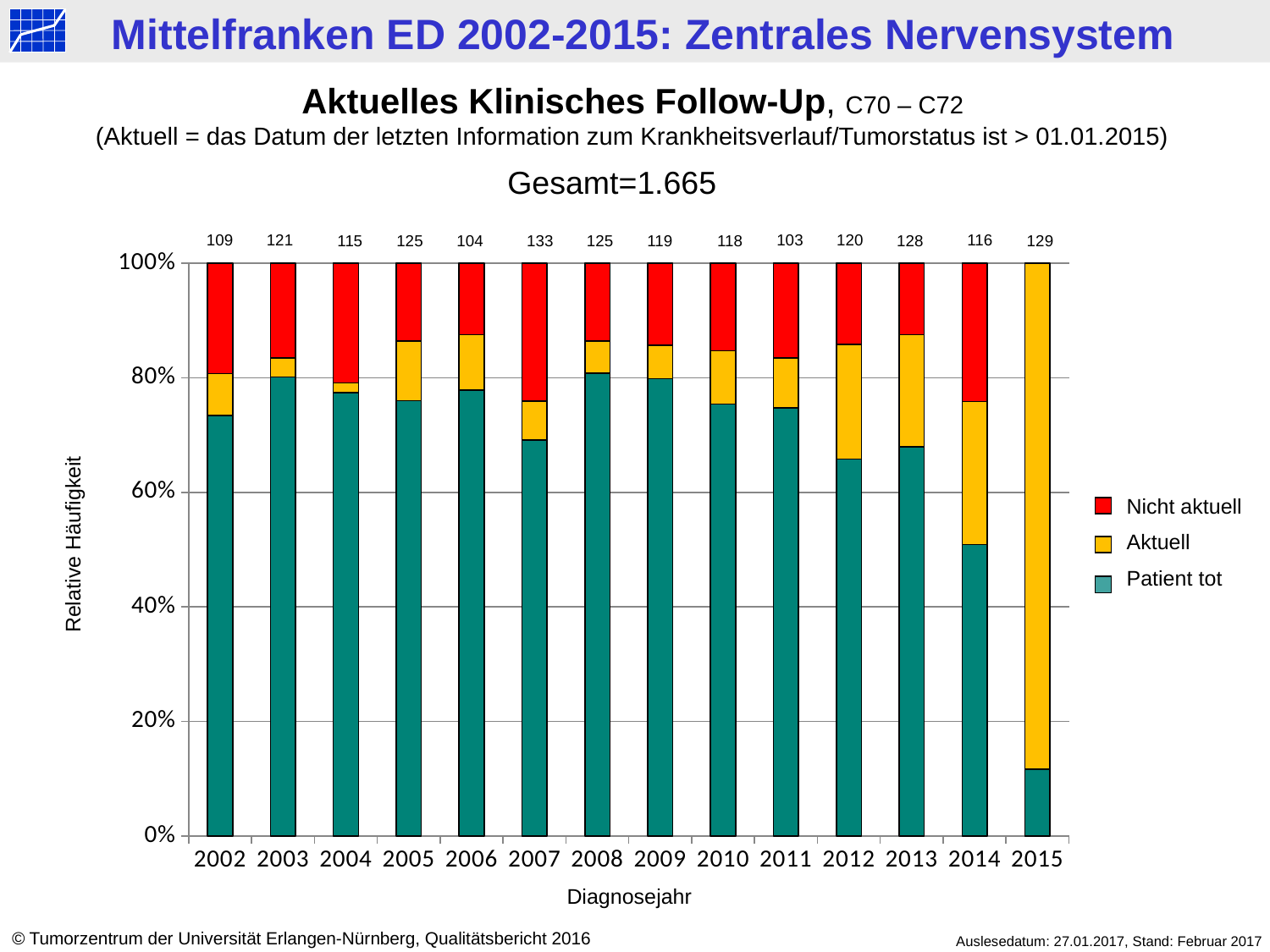
Which diagnosis year has the lowest number printed above its bar? 2011 Is the 'Patient tot' share for 2015 greater or less than 20%? less Is the 'Patient tot' share for 2014 greater or less than 60%? less Which diagnosis year has the highest number printed above its bar? 2007 What kind of chart is shown on the slide? Stacked bar chart What total (Gesamt) is stated on the slide? 1.665 Which year has a larger number printed above its bar, 2005 or 2009? 2005 How many series does the legend list? 3 What number is printed above the bar for 2011? 103 What number is printed above the bar for 2007? 133 What is the difference between the numbers printed above the bars for 2013 and 2002? 19 How many diagnosis years (categories) are shown on the x axis? 14